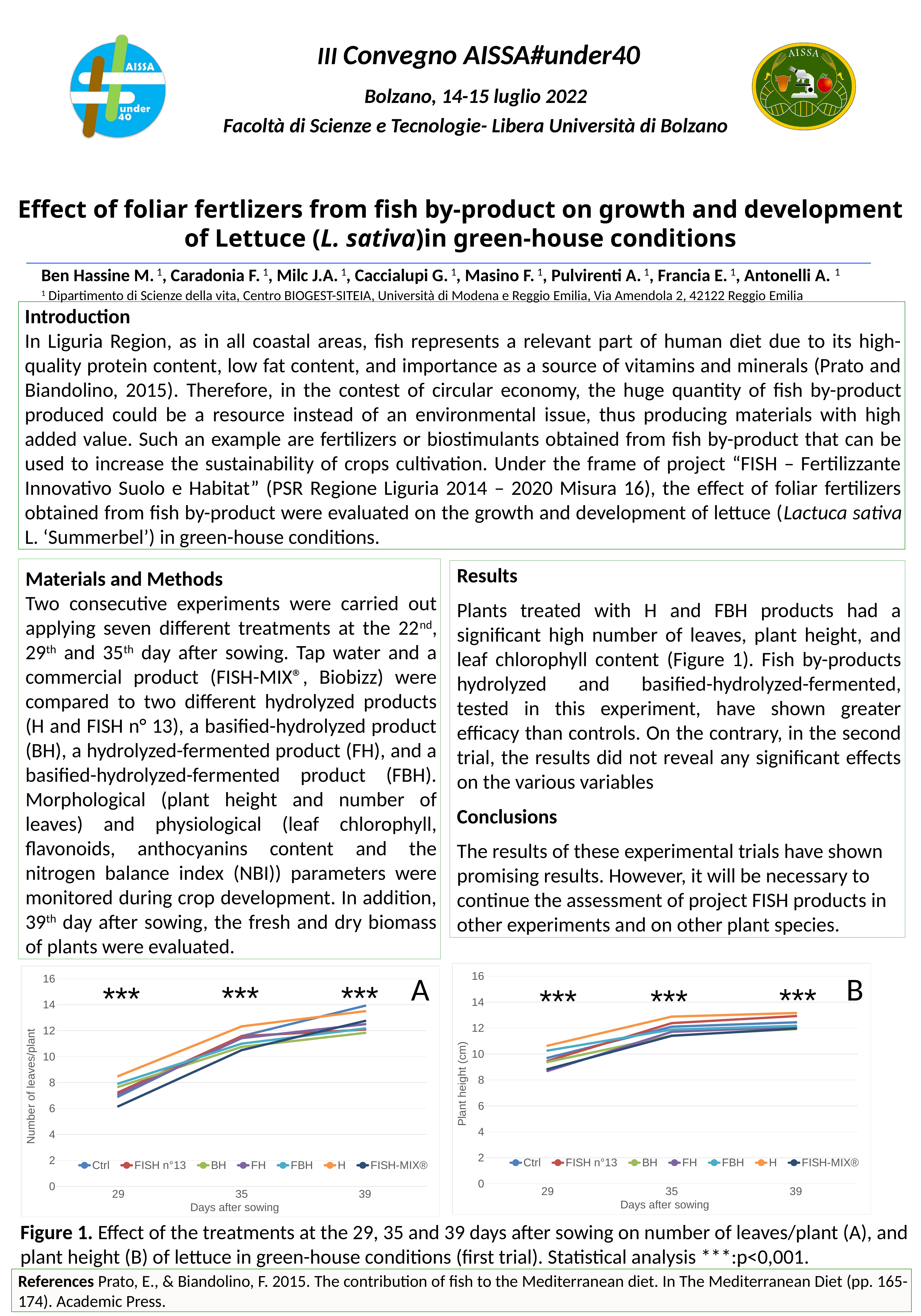
What kind of chart is chart A (Number of leaves/plant)? line chart What is the y-axis title of chart B? Plant height (cm) In chart B (Plant height), do the values rise or fall from 29 to 39 days after sowing? rise In chart A (Number of leaves/plant), which treatment has the lowest value at 29 days after sowing? FISH-MIX® In chart A (Number of leaves/plant), do the values rise or fall from 29 to 39 days after sowing? rise In chart A (Number of leaves/plant), at 29 days after sowing, which is larger: H or FISH-MIX®? H In chart B (Plant height), which treatment has the highest value at 39 days after sowing? H In chart B (Plant height), is the value for H at 39 days greater or less than 12? greater In chart A (Number of leaves/plant), is the value for FISH-MIX® at 29 days greater or less than 8? less How many series does the legend of chart B (Plant height) list? 7 How many points on the x axis (days after sowing) does chart A show? 3 In chart B (Plant height), is the value for FISH-MIX® at 29 days greater or less than 10? less